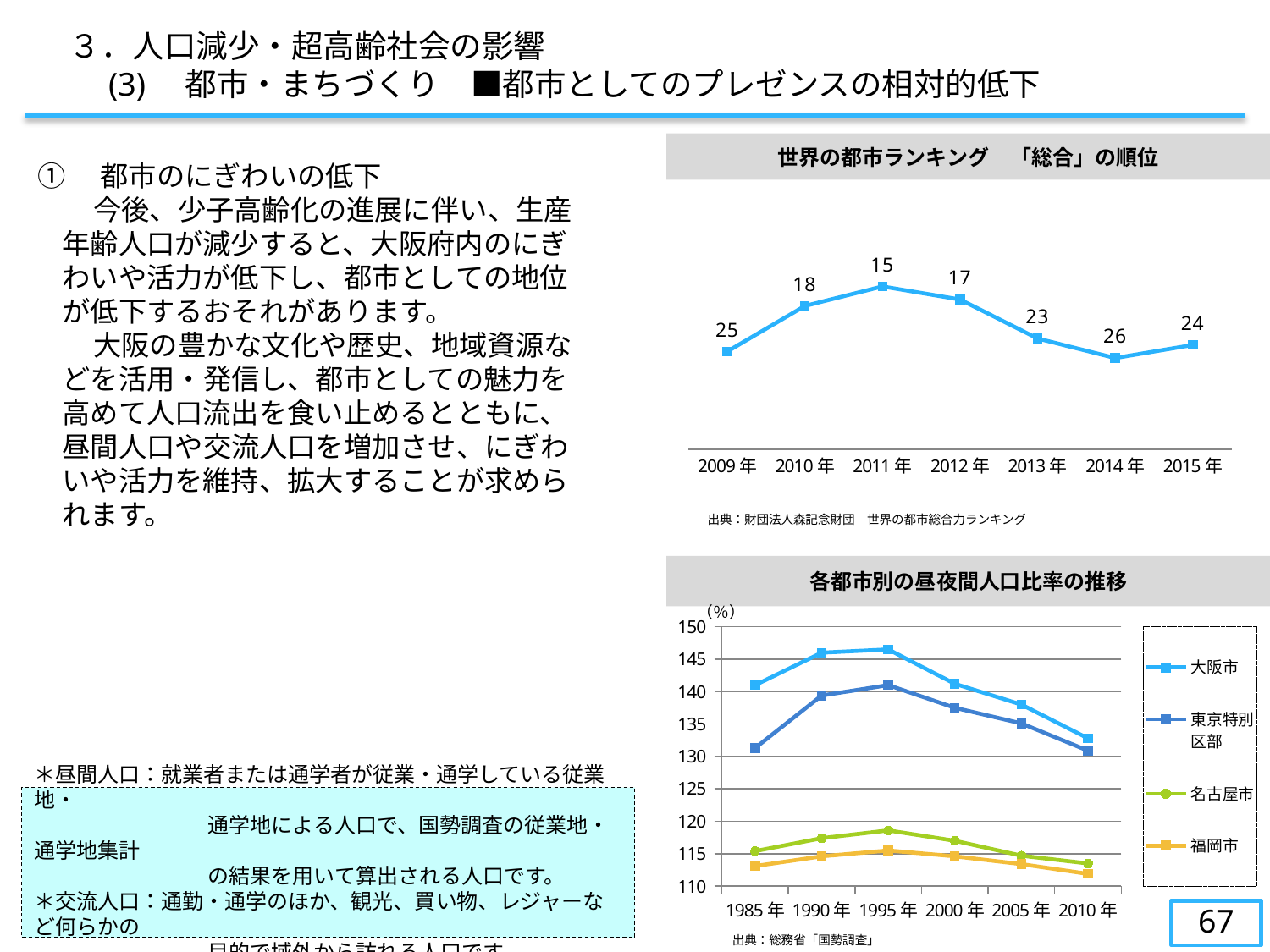
In the chart titled 世界の都市ランキング 「総合」の順位, which year has the largest numeric value? 2014年 In the chart titled 世界の都市ランキング 「総合」の順位, how many years are plotted on the x axis? 7 In the chart titled 世界の都市ランキング 「総合」の順位, what is the value for 2011年? 15 In the chart titled 世界の都市ランキング 「総合」の順位, what is the value for 2014年? 26 In the chart titled 各都市別の昼夜間人口比率の推移, do the values for 大阪市 rise or fall from 1995年 to 2010年? fall In the chart titled 世界の都市ランキング 「総合」の順位, which year has the smallest numeric value? 2011年 In the chart titled 各都市別の昼夜間人口比率の推移, how many series does the legend list? 4 In the chart titled 各都市別の昼夜間人口比率の推移, is the value for 大阪市 in 1995年 greater or less than 140? greater In the chart titled 各都市別の昼夜間人口比率の推移, which series is higher in 2000年, 名古屋市 or 福岡市? 名古屋市 What kind of chart is the chart titled 各都市別の昼夜間人口比率の推移? line chart In the chart titled 世界の都市ランキング 「総合」の順位, what is the value for 2009年? 25 In the chart titled 世界の都市ランキング 「総合」の順位, what is the difference between the values for 2009年 and 2011年? 10